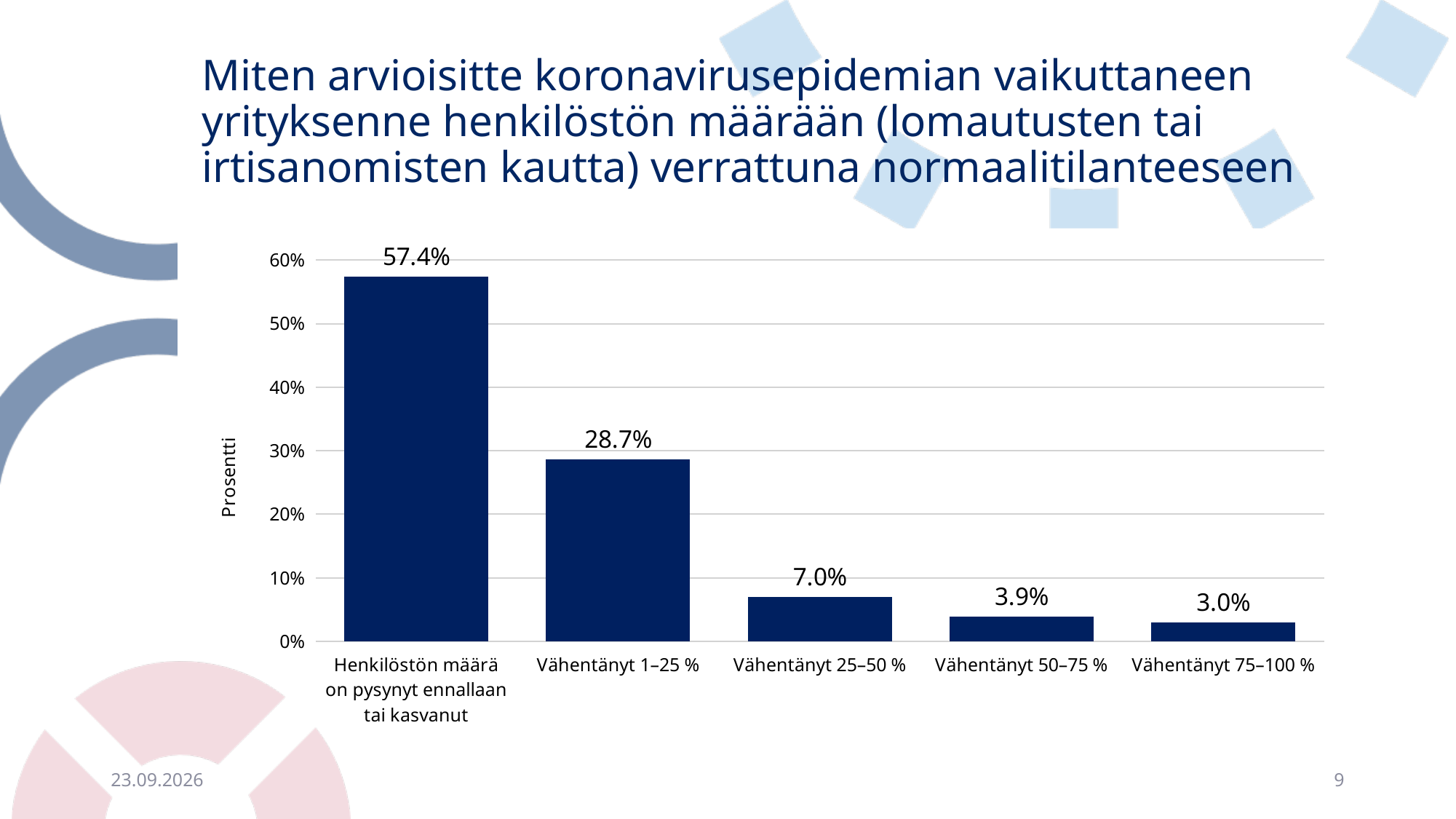
Which is larger, the value for "Vähentänyt 1–25 %" or the value for "Vähentänyt 25–50 %"? Vähentänyt 1–25 % What kind of chart is shown on the slide? Bar chart What is the value for "Henkilöstön määrä on pysynyt ennallaan tai kasvanut"? 57.4% What is the value for "Vähentänyt 1–25 %"? 28.7% Which category has the lowest value? Vähentänyt 75–100 % Which category has the highest value? Henkilöstön määrä on pysynyt ennallaan tai kasvanut How many categories are shown in the chart? 5 What is the difference between the values for "Henkilöstön määrä on pysynyt ennallaan tai kasvanut" and "Vähentänyt 1–25 %"? 28.7% What is the label of the vertical axis? Prosentti What is the value for "Vähentänyt 75–100 %"? 3.0% What is the value for "Vähentänyt 25–50 %"? 7.0% What is the difference between the values for "Vähentänyt 25–50 %" and "Vähentänyt 50–75 %"? 3.1%